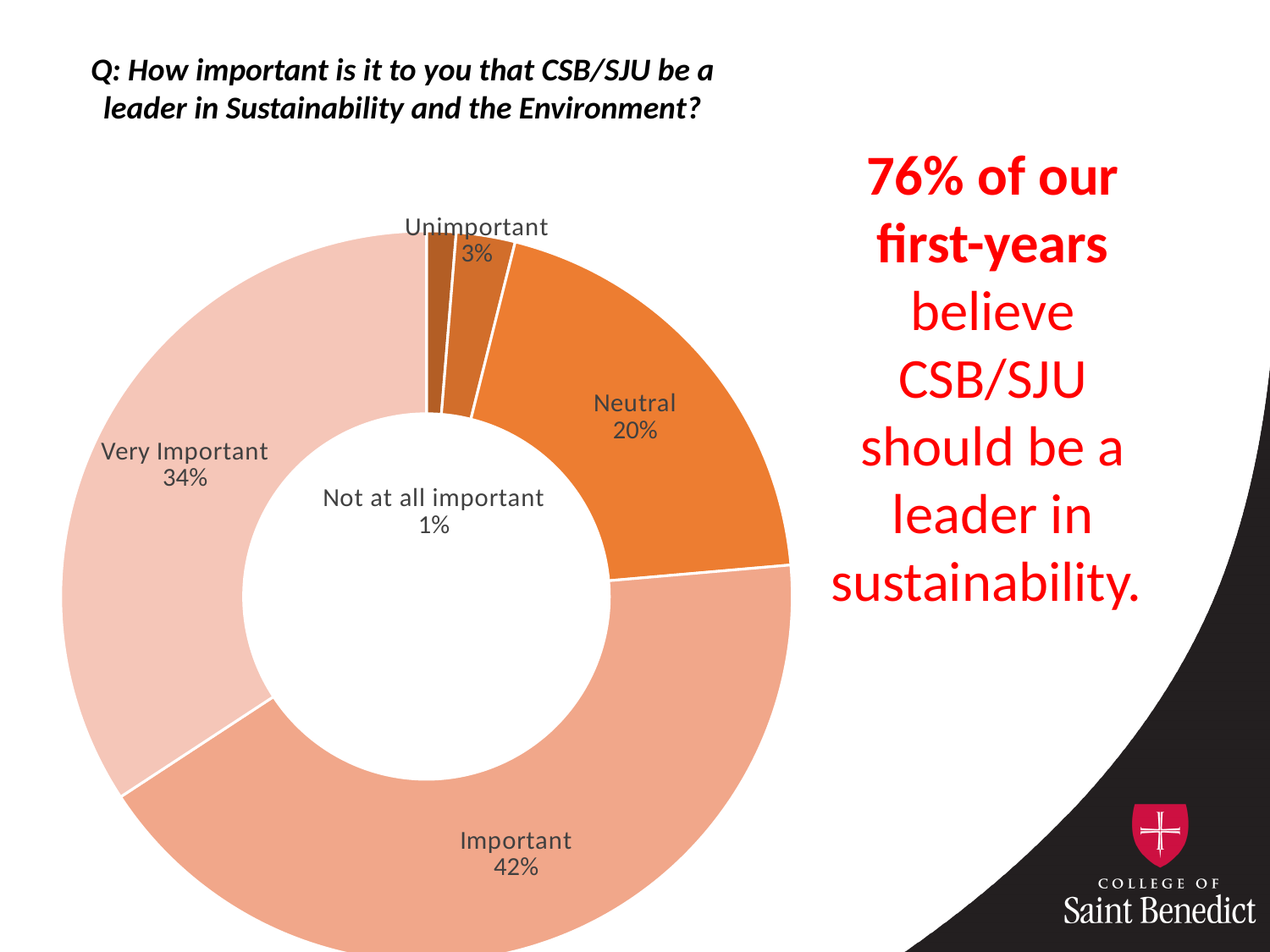
Which response category has the largest share of the chart? Important What percentage of respondents answered Not at all important? 1% What percentage of respondents answered Unimportant? 3% Which response category has the smallest share of the chart? Not at all important What percentage of respondents answered Neutral? 20% What share of respondents said it is Very Important that CSB/SJU be a leader in Sustainability and the Environment? 34% What kind of chart is shown on the slide? Doughnut (pie) chart How many response categories are shown in the chart? 5 Which is larger, the Neutral share or the Very Important share? Very Important What is the combined share of respondents who answered Very Important or Important? 76% How many percentage points larger is the Important share than the Very Important share? 8 What percentage of respondents answered Important? 42%